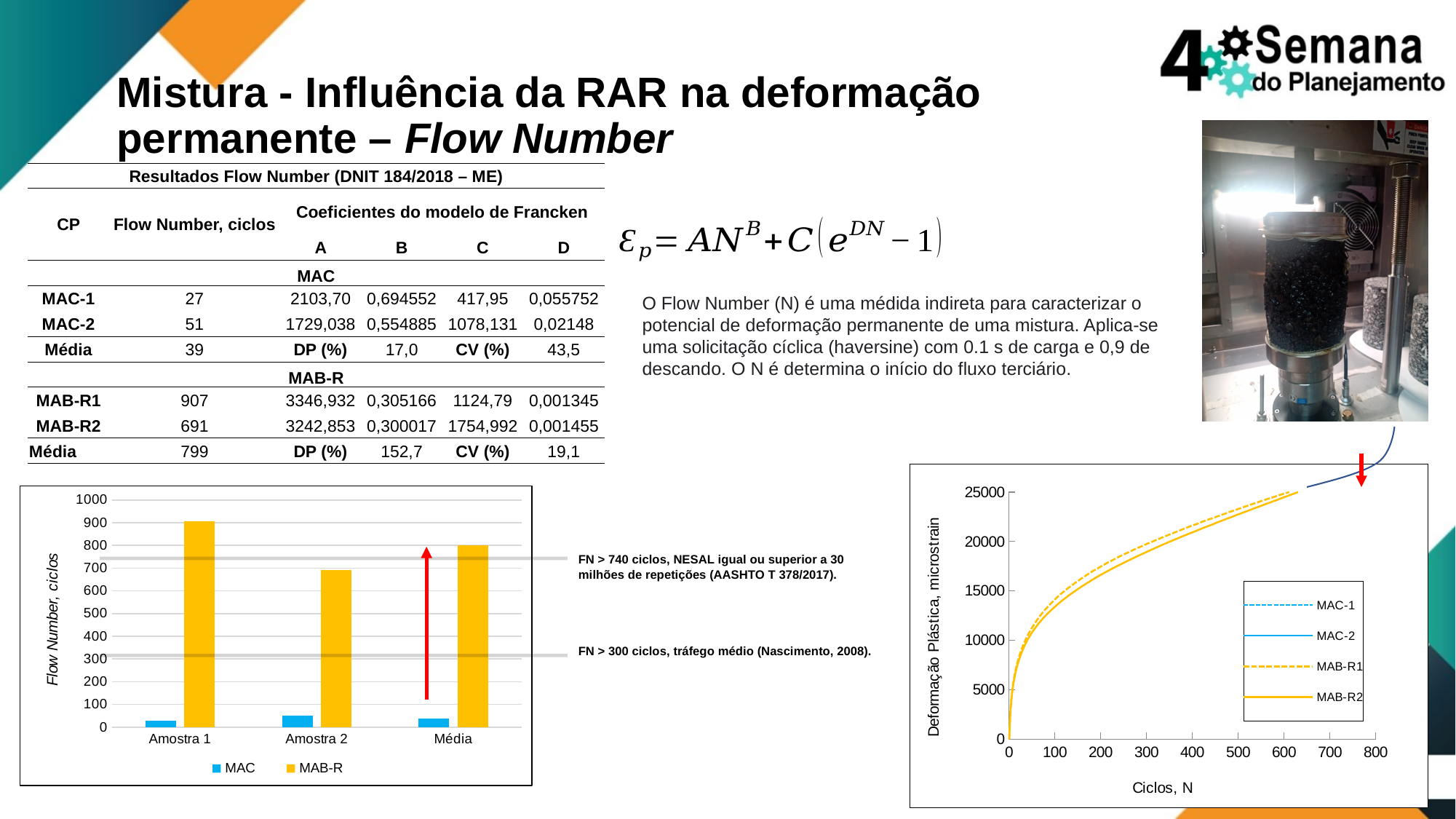
What kind of chart is the chart at the bottom left of the slide (Flow Number, ciclos)? bar chart In the bottom-left bar chart, how many categories are shown on the x axis? 3 In the bottom-left bar chart, is the MAB-R value for Média greater or less than 700? greater In the bottom-left bar chart, which category has the highest MAB-R bar? Amostra 1 In the bottom-left bar chart, is the MAC value for Amostra 2 greater or less than 100? less In the bottom-left bar chart, for Média, which series has the larger value, MAC or MAB-R? MAB-R In the bottom-right line chart, do the plotted values rise or fall as Ciclos, N increases? rise In the bottom-left bar chart, is the MAB-R value for Amostra 1 greater or less than 800? greater In the bottom-left bar chart, how many series does the legend list? 2 In the bottom-right line chart, how many series does the legend list? 4 In the bottom-left bar chart, which category has the lowest MAB-R bar? Amostra 2 What kind of chart is the chart at the bottom right of the slide (Deformação Plástica vs Ciclos, N)? line chart